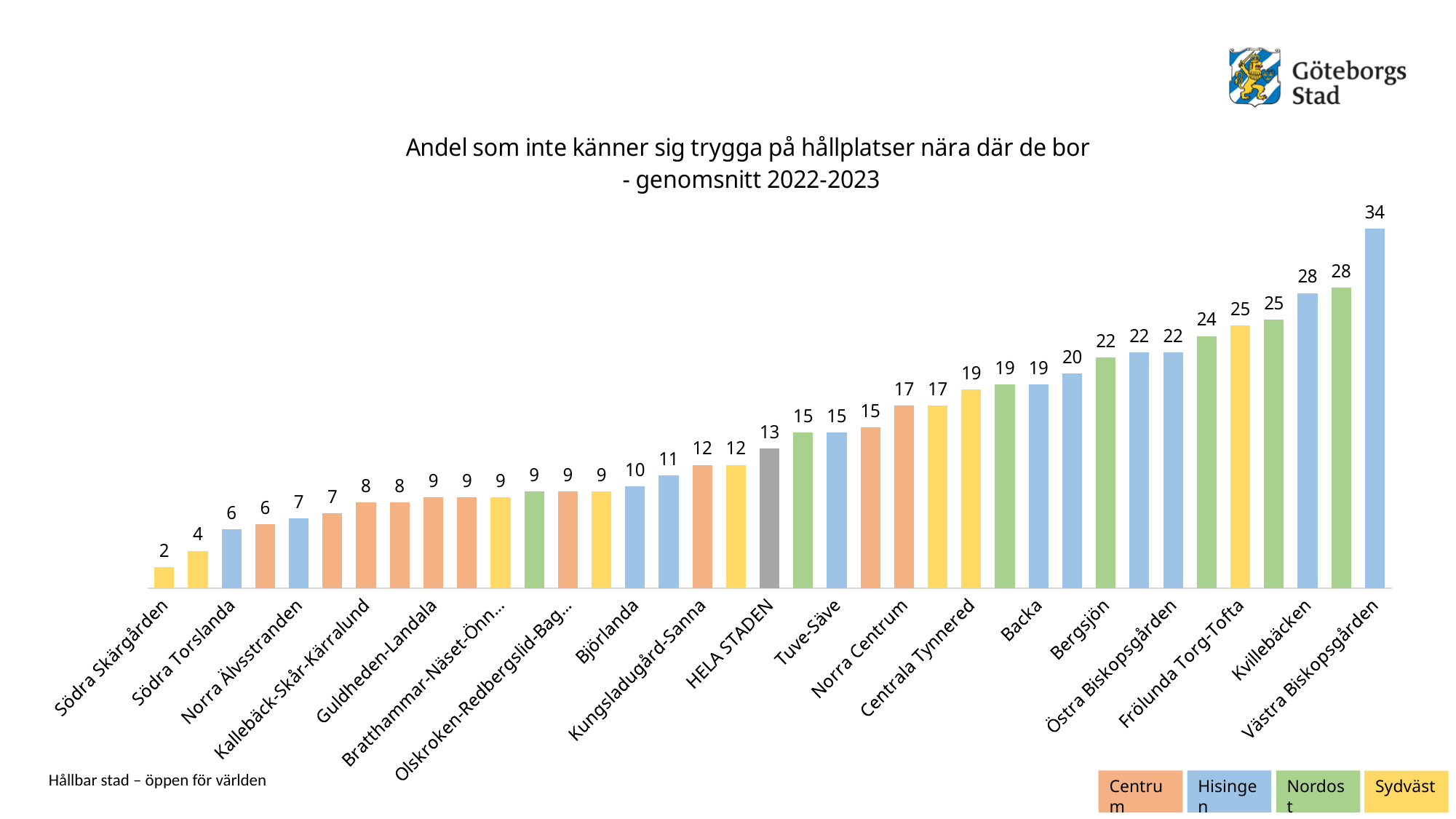
Which has a larger value, Backa or Kvillebäcken? Kvillebäcken Do the values rise or fall from left to right along the x axis? Rise What is the value for HELA STADEN? 13 How many entries does the legend list? 4 What is the difference between the values for Västra Biskopsgården and Södra Skärgården? 32 What is the value for Västra Biskopsgården? 34 What is the value for Kvillebäcken? 28 Which category has the lowest value? Södra Skärgården What is the value for Björlanda? 10 What kind of chart is shown? Bar chart Which category has the highest value? Västra Biskopsgården What is the value for Södra Skärgården? 2